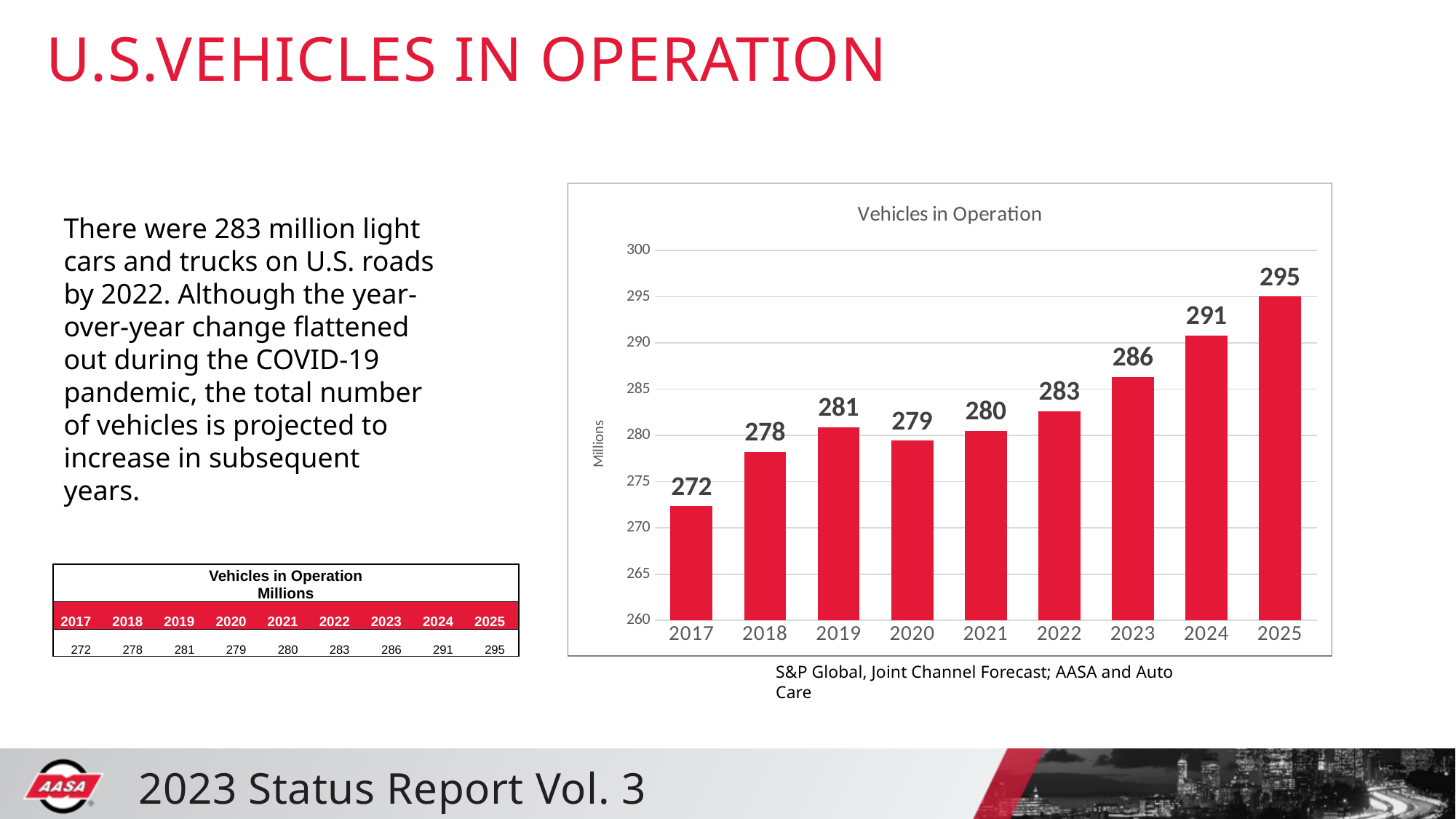
Is the value for 2024 in the Vehicles in Operation chart greater or less than 285? greater How many years are shown in the Vehicles in Operation chart? 9 What is the value for 2025 in the Vehicles in Operation chart? 295 What is the value for 2017 in the Vehicles in Operation chart? 272 What is the difference between the values for 2025 and 2017 in the Vehicles in Operation chart? 23 Which is larger in the Vehicles in Operation chart, the value for 2019 or the value for 2020? 2019 What is the value for 2022 in the Vehicles in Operation chart? 283 Which year has the lowest value in the Vehicles in Operation chart? 2017 What is the difference between the values for 2024 and 2023 in the Vehicles in Operation chart? 5 Which year has the highest value in the Vehicles in Operation chart? 2025 What unit is shown on the vertical axis of the Vehicles in Operation chart? Millions What kind of chart is the Vehicles in Operation chart? Bar chart